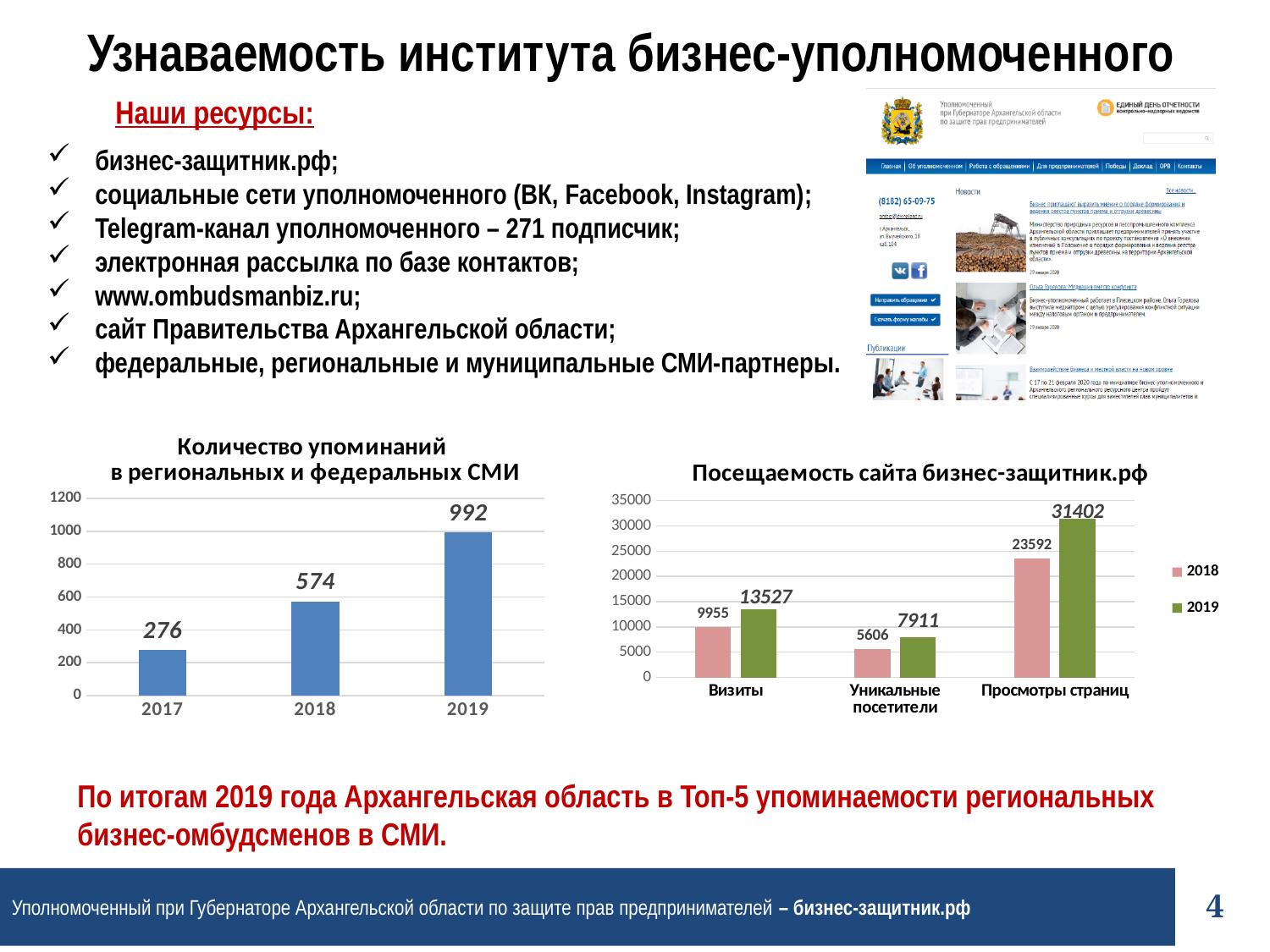
In the chart 'Количество упоминаний в региональных и федеральных СМИ', what is the value for 2019? 992 In the chart 'Посещаемость сайта бизнес-защитник.рф', what is the 2019 value for Просмотры страниц? 31402 In the chart 'Посещаемость сайта бизнес-защитник.рф', what is the 2018 value for Уникальные посетители? 5606 In the chart 'Количество упоминаний в региональных и федеральных СМИ', what is the difference between the 2019 and 2018 values? 418 In the chart 'Посещаемость сайта бизнес-защитник.рф', which is larger: the 2018 value for Визиты or the 2019 value for Уникальные посетители? 2018 value for Визиты In the chart 'Количество упоминаний в региональных и федеральных СМИ', how many years are shown? 3 In the chart 'Количество упоминаний в региональных и федеральных СМИ', what is the value for 2017? 276 What kind of chart is 'Посещаемость сайта бизнес-защитник.рф'? bar chart In the chart 'Количество упоминаний в региональных и федеральных СМИ', which year has the lowest value? 2017 In the chart 'Количество упоминаний в региональных и федеральных СМИ', do the values rise or fall from 2017 to 2019? rise In the chart 'Посещаемость сайта бизнес-защитник.рф', how many series does the legend list? 2 In the chart 'Посещаемость сайта бизнес-защитник.рф', what is the difference between the 2019 and 2018 values for Визиты? 3572